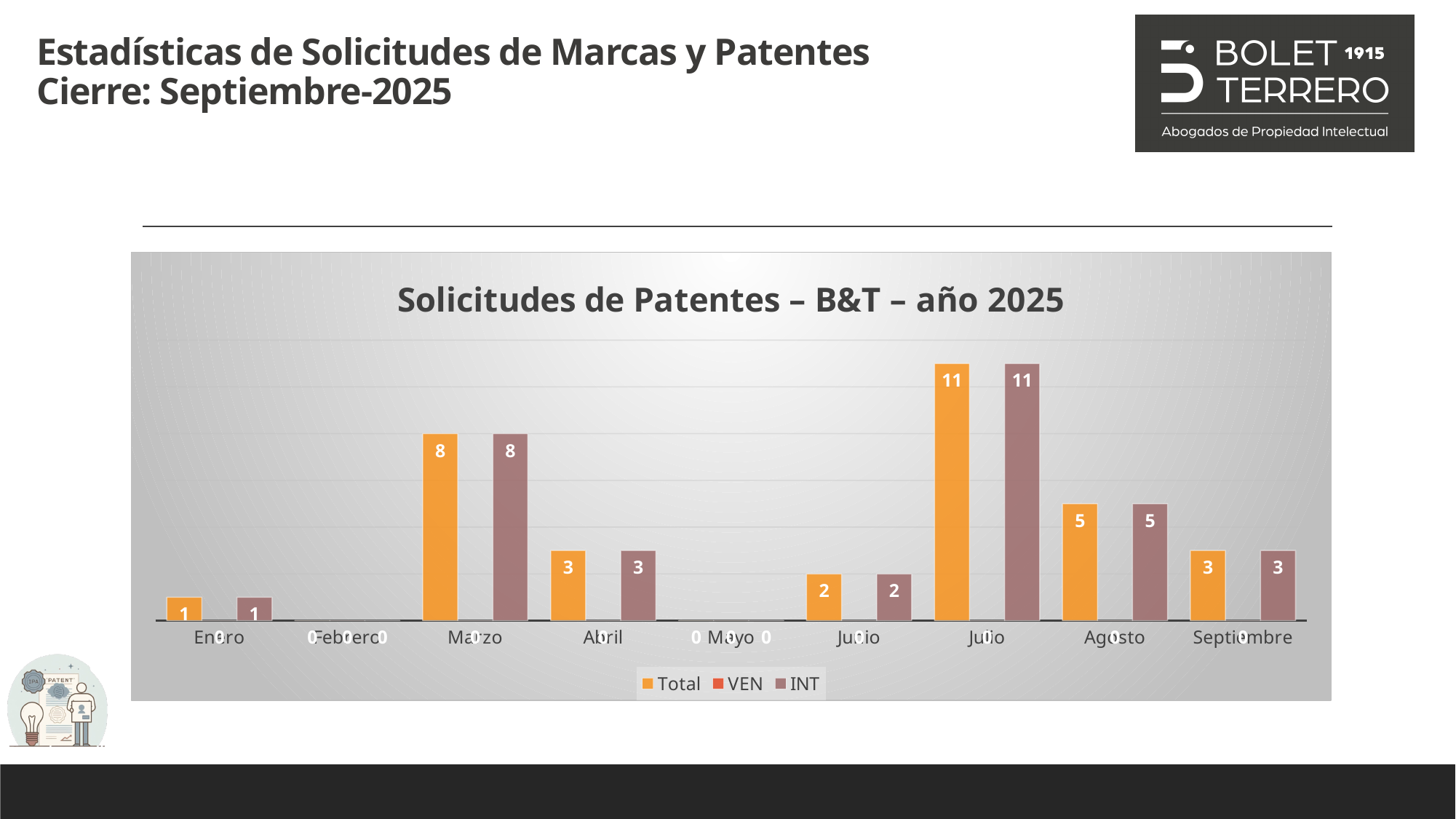
Which month has the highest Total value? Julio What is the title of the chart? Solicitudes de Patentes – B&T – año 2025 What is the Total value for Marzo? 8 What kind of chart is shown? Bar chart What is the Total value for Agosto? 5 How many series does the legend list? 3 What is the VEN value for Marzo? 0 What is the INT value for Junio? 2 What is the INT value for Julio? 11 How many months are shown on the x axis? 9 What is the difference between the Total values for Julio and Marzo? 3 Which is larger, the Total value for Abril or the Total value for Agosto? Agosto